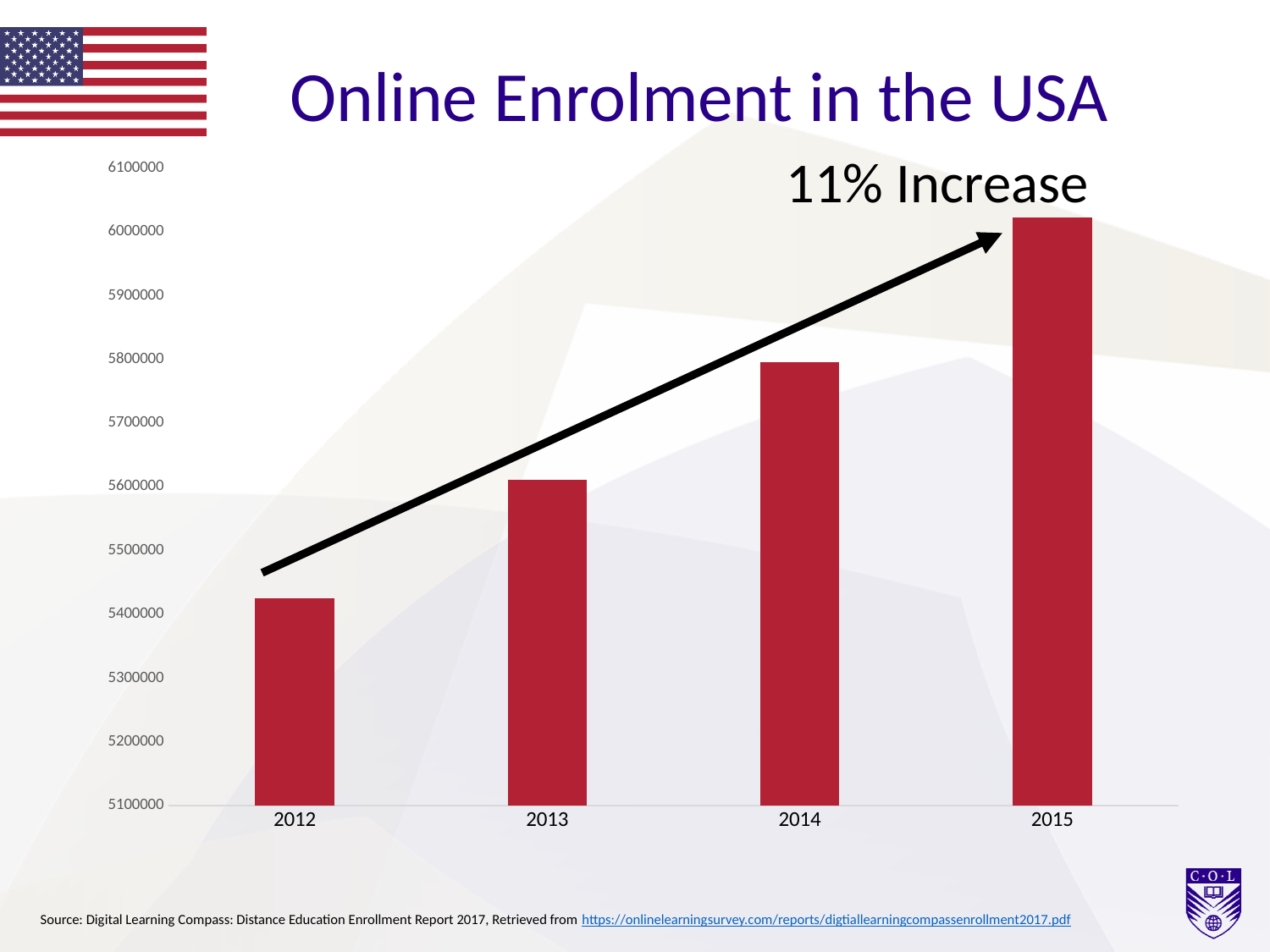
What kind of chart is shown on the slide? bar chart Is the value for 2015 greater or less than 6000000? greater What is the title of the chart? Online Enrolment in the USA Which year has the larger value, 2013 or 2014? 2014 Which year has the lowest online enrolment in the chart? 2012 How many years are shown on the x axis of the chart? 4 Do the values rise or fall from 2012 to 2015? rise What percentage increase is annotated on the chart? 11% Increase Is the value for 2012 greater or less than 5500000? less Which year has the highest online enrolment in the chart? 2015